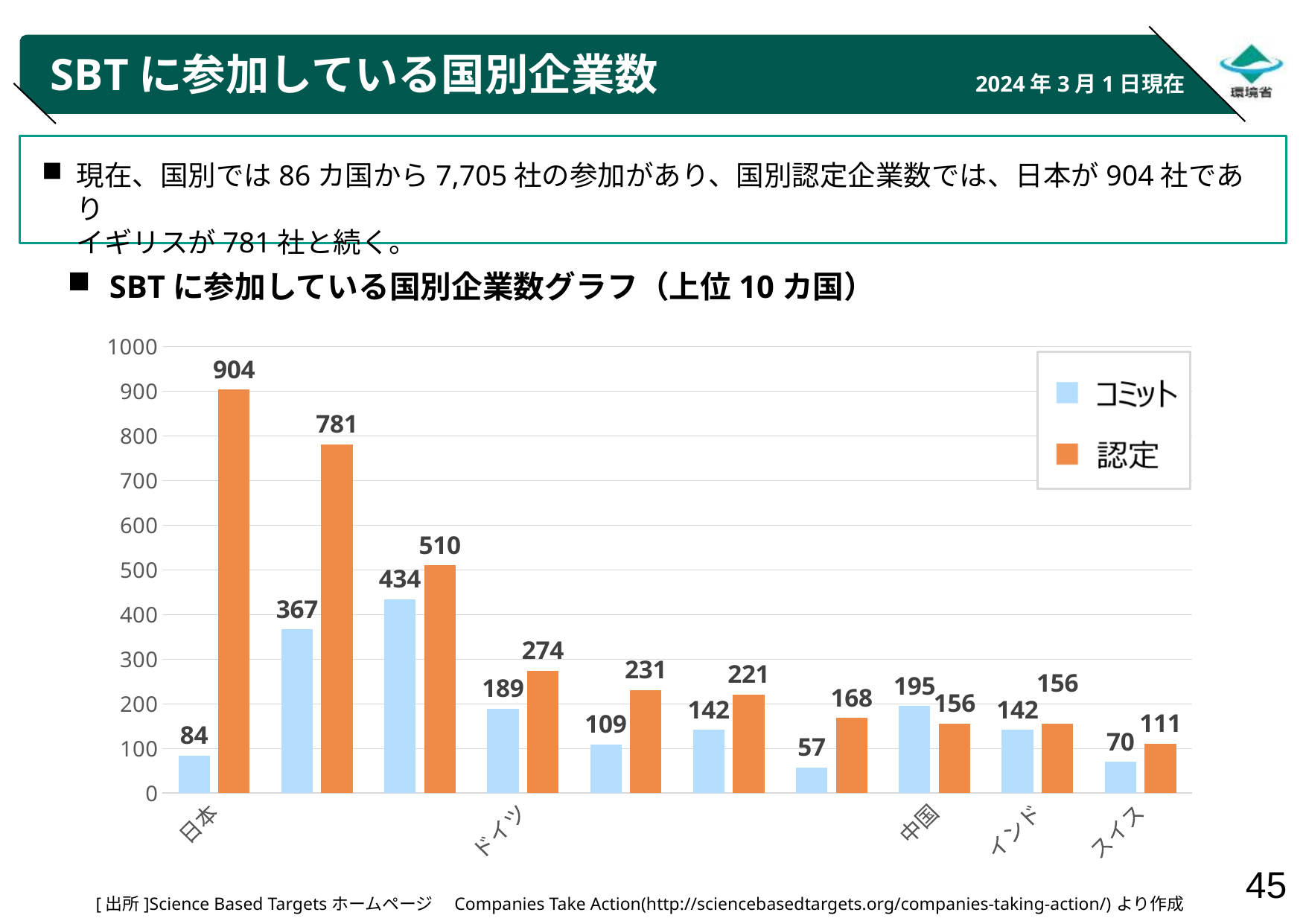
What is the 認定 value for ドイツ? 274 Which country has the highest 認定 value? 日本 What is the コミット value for 中国? 195 What is the 認定 value for スイス? 111 What kind of chart is shown on the slide? Bar chart What is the 認定 value for 日本? 904 How many series does the legend list? 2 How many countries are shown on the chart? 10 What is the コミット value for 日本? 84 What is the difference between the 認定 and コミット values for 日本? 820 For 中国, which is larger, the コミット value or the 認定 value? コミット What is the difference between the コミット values for 中国 and インド? 53